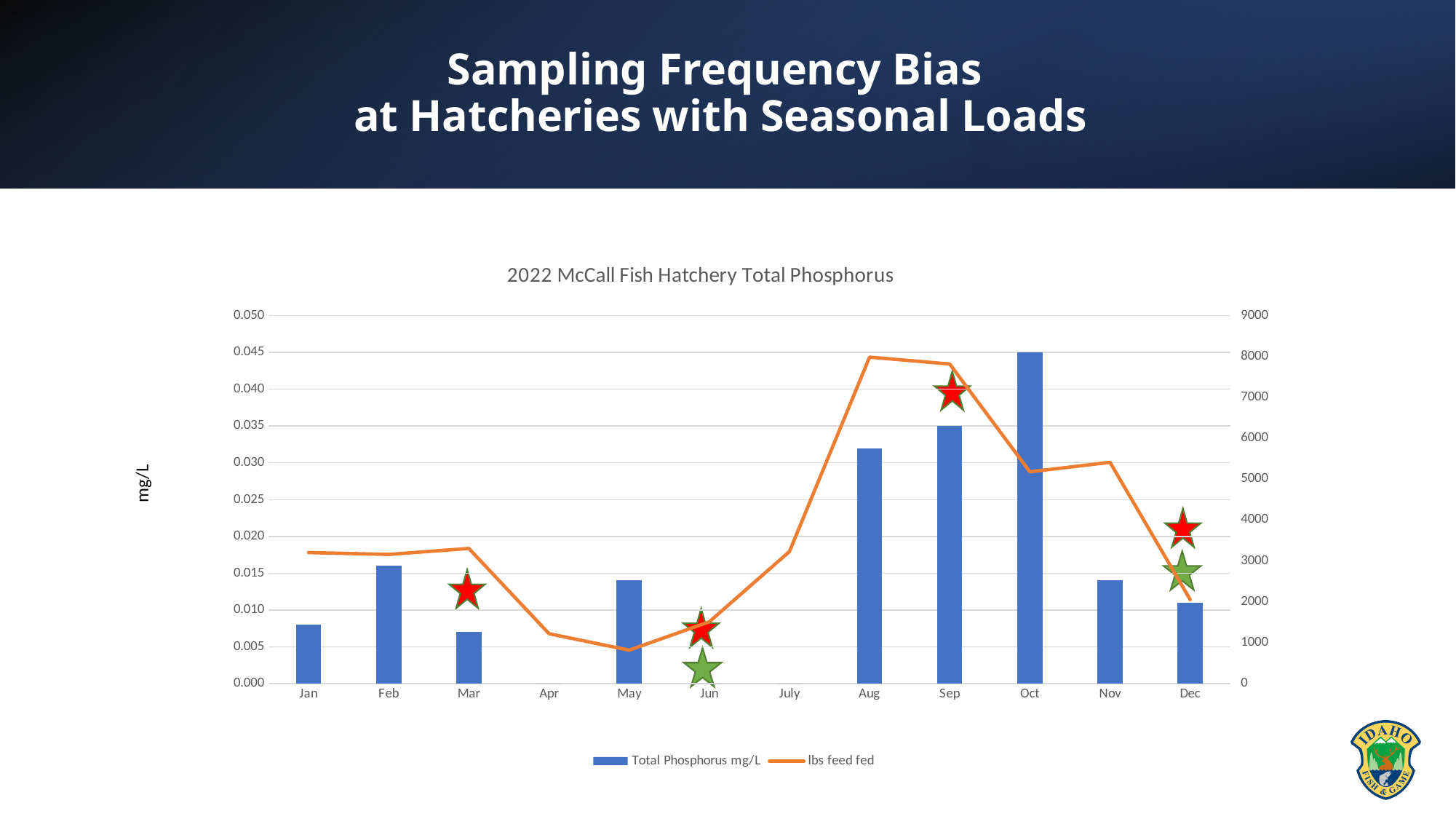
Is the Total Phosphorus value for Aug greater or less than 0.030? greater Which has the larger Total Phosphorus bar, Sep or Nov? Sep What is the Total Phosphorus value for Oct? 0.045 Is the lbs feed fed value for May greater or less than 1000? less How many months are shown on the x axis? 12 What are the two series named in the legend? Total Phosphorus mg/L and lbs feed fed What kind of chart is shown on the slide? A combination bar and line chart Which month has the highest Total Phosphorus bar? Oct How many series does the legend list? 2 Is the Total Phosphorus value for Feb greater or less than 0.020? less What is the title of the chart? 2022 McCall Fish Hatchery Total Phosphorus Does the lbs feed fed line rise or fall from Aug to Dec? Falls